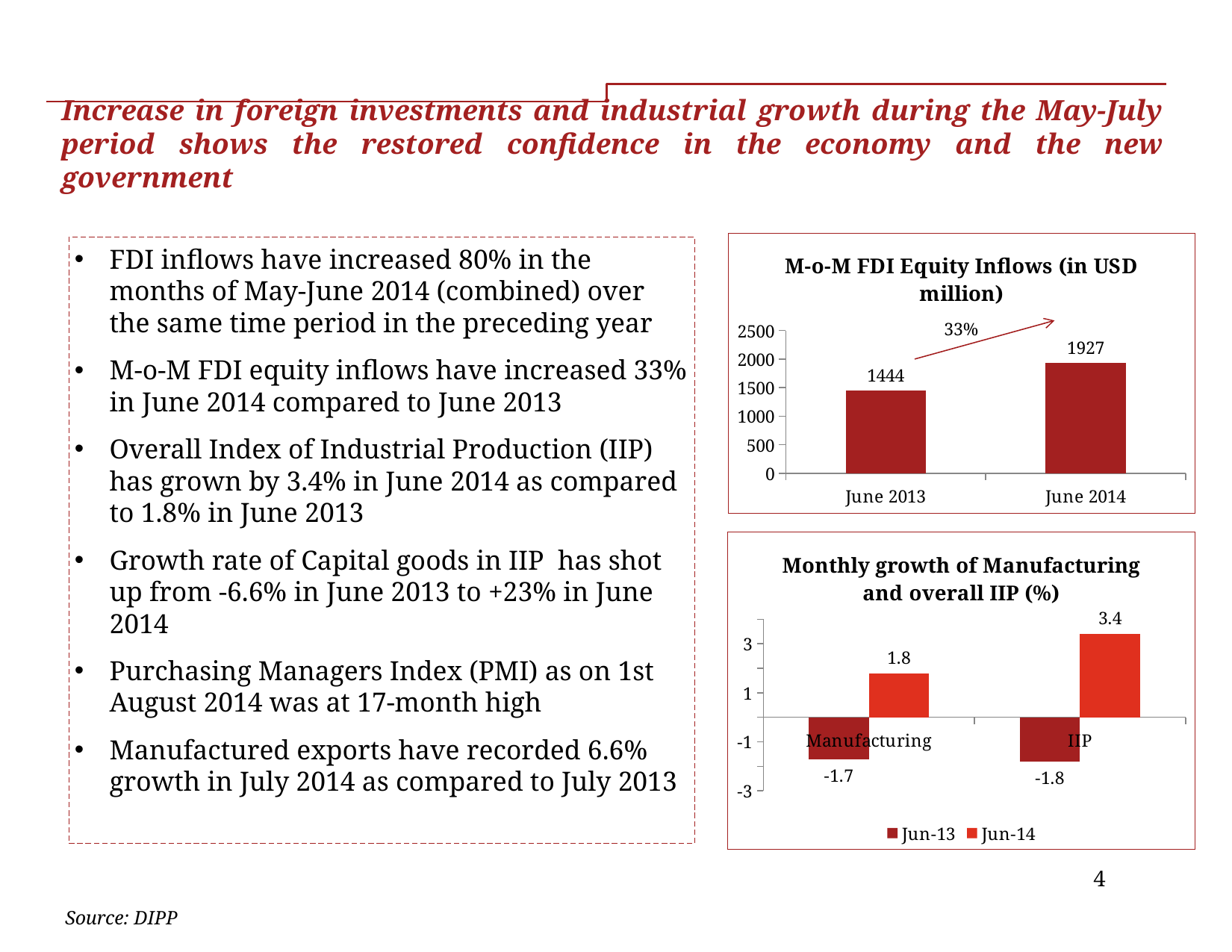
In the 'Monthly growth of Manufacturing and overall IIP (%)' chart, which is larger: the Jun-14 value for IIP or the Jun-14 value for Manufacturing? IIP In the 'M-o-M FDI Equity Inflows (in USD million)' chart, what is the value for June 2014? 1927 In the 'Monthly growth of Manufacturing and overall IIP (%)' chart, what is the Jun-14 value for Manufacturing? 1.8 In the 'Monthly growth of Manufacturing and overall IIP (%)' chart, what is the Jun-13 value for Manufacturing? -1.7 What kind of chart is the 'M-o-M FDI Equity Inflows (in USD million)' chart? Bar chart In the 'M-o-M FDI Equity Inflows (in USD million)' chart, what percentage increase is annotated between the two bars? 33% In the 'M-o-M FDI Equity Inflows (in USD million)' chart, what is the difference between the June 2014 and June 2013 values? 483 In the 'M-o-M FDI Equity Inflows (in USD million)' chart, which category has the higher value? June 2014 In the 'Monthly growth of Manufacturing and overall IIP (%)' chart, what is the difference between the Jun-14 and Jun-13 values for IIP? 5.2 In the 'Monthly growth of Manufacturing and overall IIP (%)' chart, how many series does the legend list? 2 In the 'M-o-M FDI Equity Inflows (in USD million)' chart, what is the value for June 2013? 1444 In the 'Monthly growth of Manufacturing and overall IIP (%)' chart, what is the Jun-14 value for IIP? 3.4